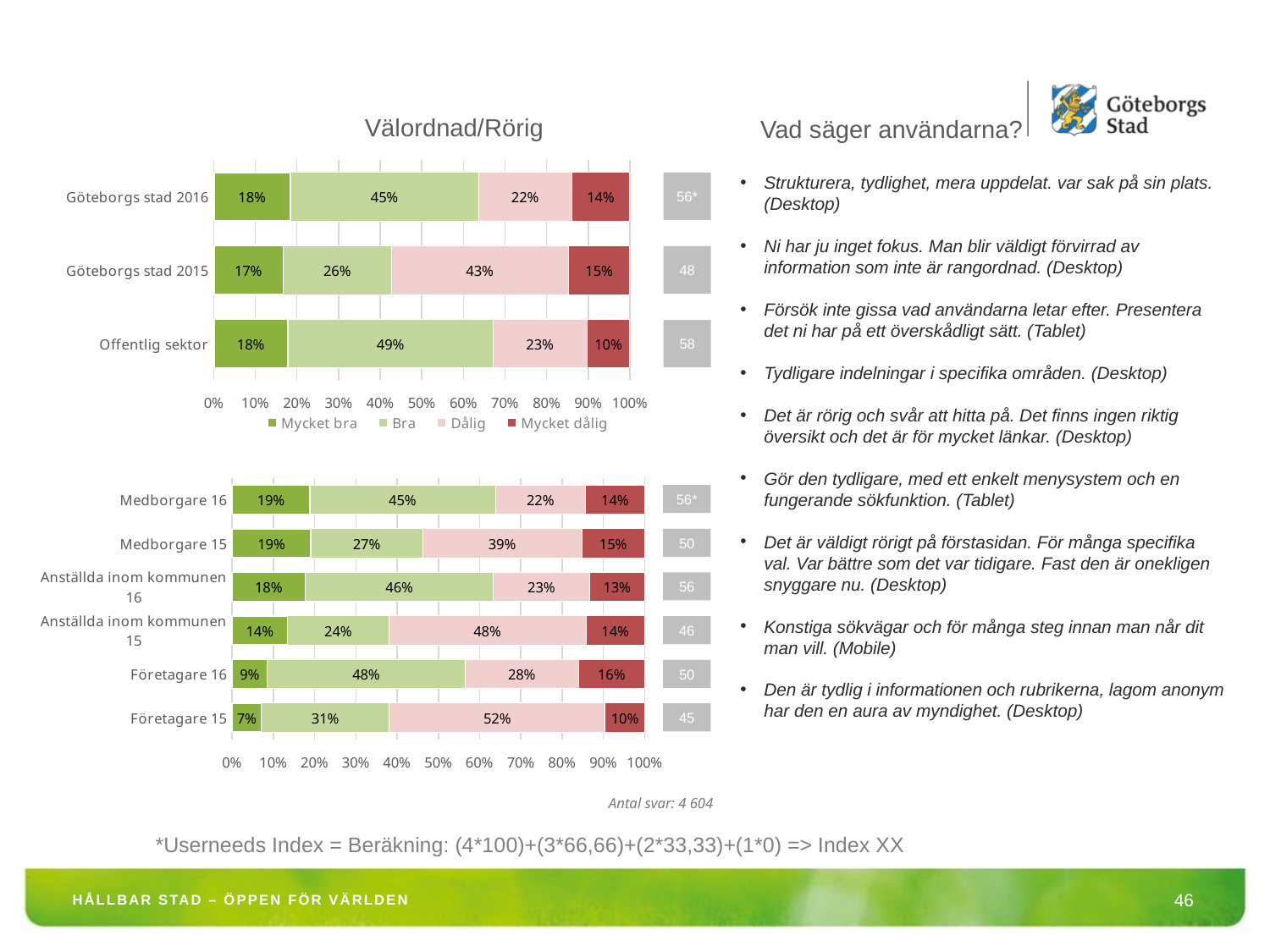
In the top chart titled Välordnad/Rörig, what kind of chart is shown? Stacked bar chart In the top chart titled Välordnad/Rörig, what is the Bra value for Offentlig sektor? 49% In the top chart titled Välordnad/Rörig, which category has the lowest Mycket dålig value? Offentlig sektor In the top chart titled Välordnad/Rörig, which category has the highest Dålig value? Göteborgs stad 2015 In the bottom chart, what is the Dålig (light pink) value for Företagare 15? 52% In the top chart titled Välordnad/Rörig, what is the Mycket bra value for Göteborgs stad 2016? 18% In the bottom chart, which is larger: the Mycket bra value for Medborgare 16 or for Företagare 16? Medborgare 16 In the bottom chart, what is the difference between the Bra values for Företagare 16 and Företagare 15? 17% In the top chart titled Välordnad/Rörig, how many series does the legend list? 4 In the top chart titled Välordnad/Rörig, what is the Dålig value for Göteborgs stad 2015? 43% In the bottom chart, how many categories are shown? 6 In the top chart titled Välordnad/Rörig, what is the difference between the Bra values for Göteborgs stad 2016 and Göteborgs stad 2015? 19%